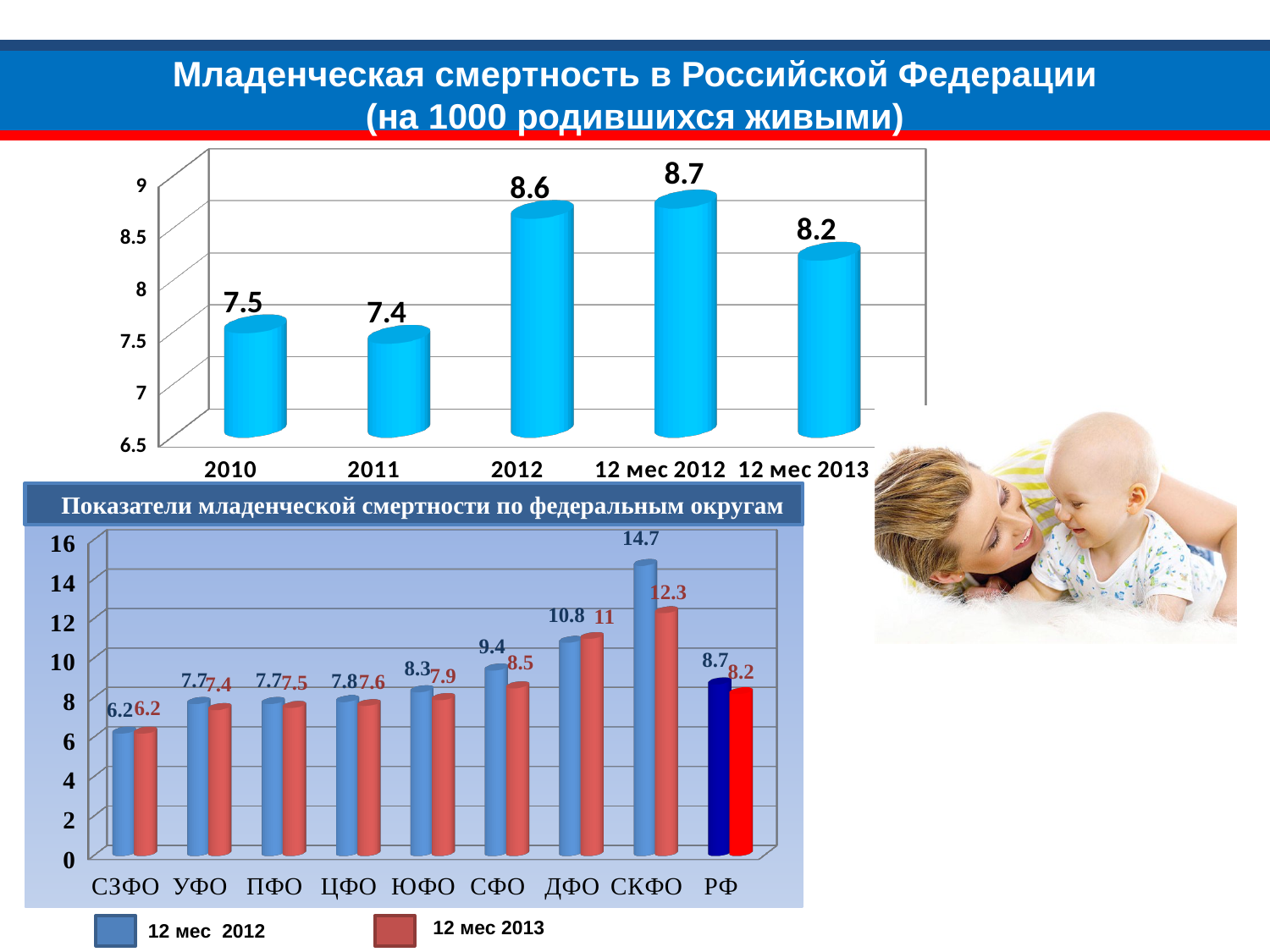
In the bottom chart 'Показатели младенческой смертности по федеральным округам', which is larger for ДФО: the 12 мес 2012 value or the 12 мес 2013 value? 12 мес 2013 In the top chart, what is the difference between the values for 12 мес 2012 and 12 мес 2013? 0.5 In the top chart, what is the infant mortality value for 2012? 8.6 In the bottom chart 'Показатели младенческой смертности по федеральным округам', which federal district has the highest value for 12 мес 2012? СКФО In the bottom chart 'Показатели младенческой смертности по федеральным округам', which category has the lowest value for 12 мес 2013? СЗФО In the bottom chart 'Показатели младенческой смертности по федеральным округам', what is the value for СКФО in 12 мес 2013? 12.3 In the bottom chart 'Показатели младенческой смертности по федеральным округам', how many series does the legend list? 2 In the top chart, which category has the lowest value? 2011 What kind of chart is the top chart? bar chart In the top chart, how many categories are shown on the x axis? 5 In the bottom chart 'Показатели младенческой смертности по федеральным округам', what is the difference between the 12 мес 2012 and 12 мес 2013 values for СКФО? 2.4 In the top chart, which category has the highest value? 12 мес 2012